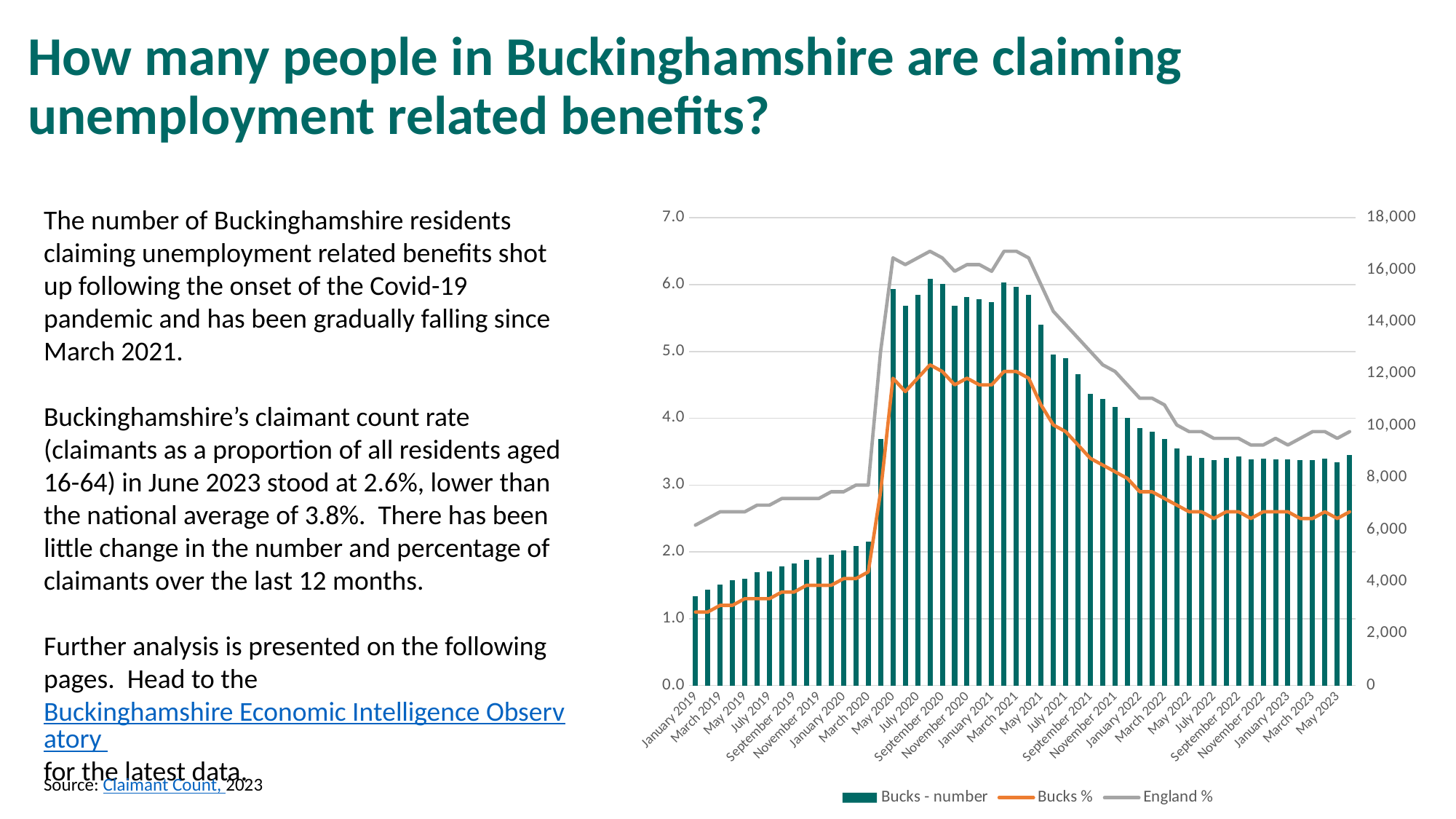
Is the Bucks % value for January 2019 greater or less than 2.0? less What are the three series named in the chart legend? Bucks - number, Bucks %, England % Is the Bucks % value for May 2023 greater or less than 3.0? less Do the Bucks - number bars rise or fall between March 2021 and May 2023? fall Which series is plotted as bars? Bucks - number Is the Bucks - number value for January 2019 greater or less than 4,000? less In May 2023, which line is higher: Bucks % or England %? England % Which month has the lowest bar for Bucks - number? January 2019 How many series does the chart legend list? 3 What kind of chart is shown on the slide? Combined bar and line chart